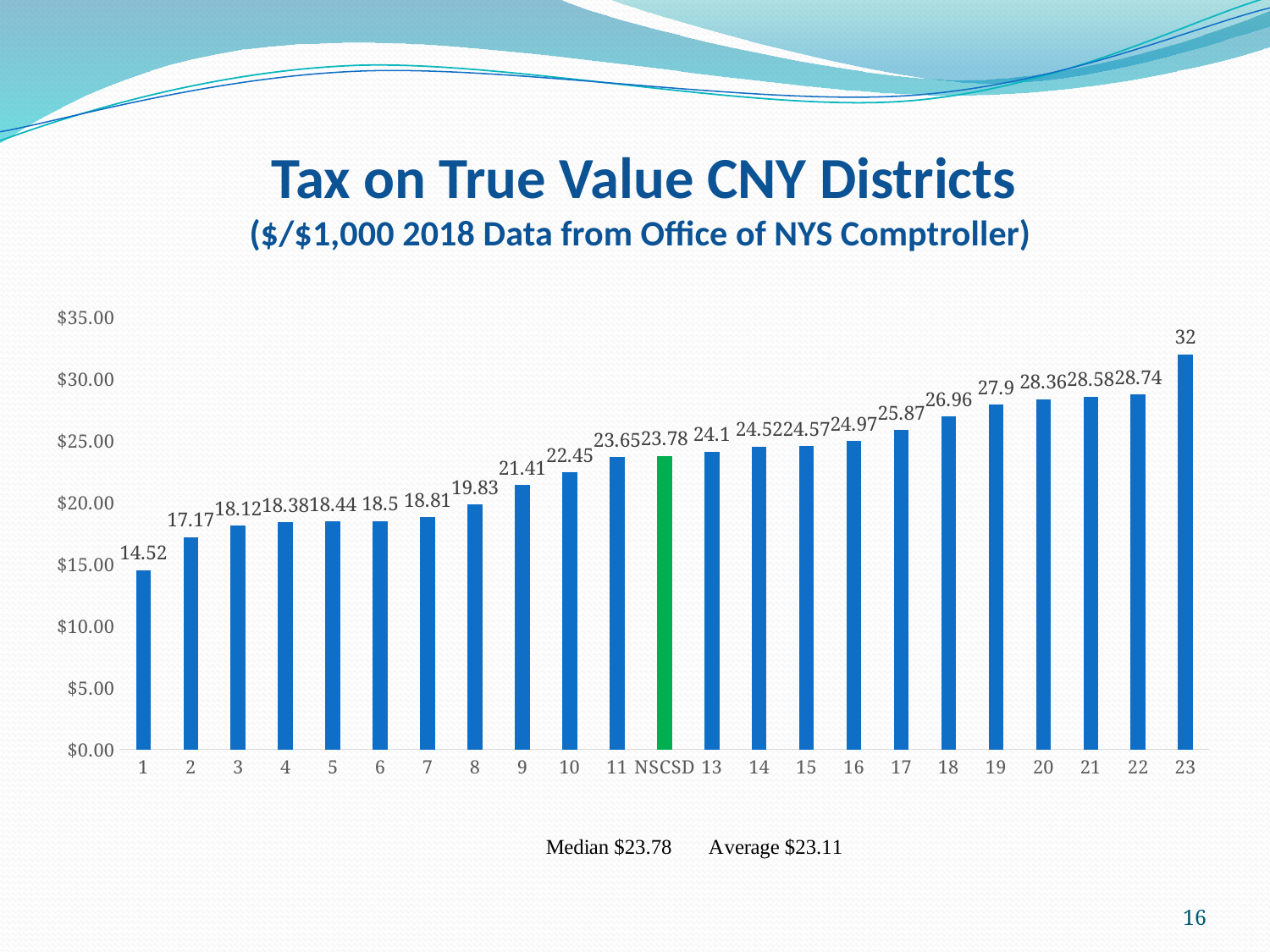
Which bar is coloured green instead of blue? NSCSD Do the values rise or fall from left to right along the x axis? rise What kind of chart is this? bar chart Which category has the lowest value? 1 What is the value for NSCSD? 23.78 What is the value for district 23? 32 How many categories are shown on the x axis? 23 Is the value for district 5 greater or less than $20.00? less Which is larger, the value for district 9 or the value for district 18? 18 Which category has the highest value? 23 What is the difference between the values for district 23 and district 1? 17.48 What is the value for district 1? 14.52